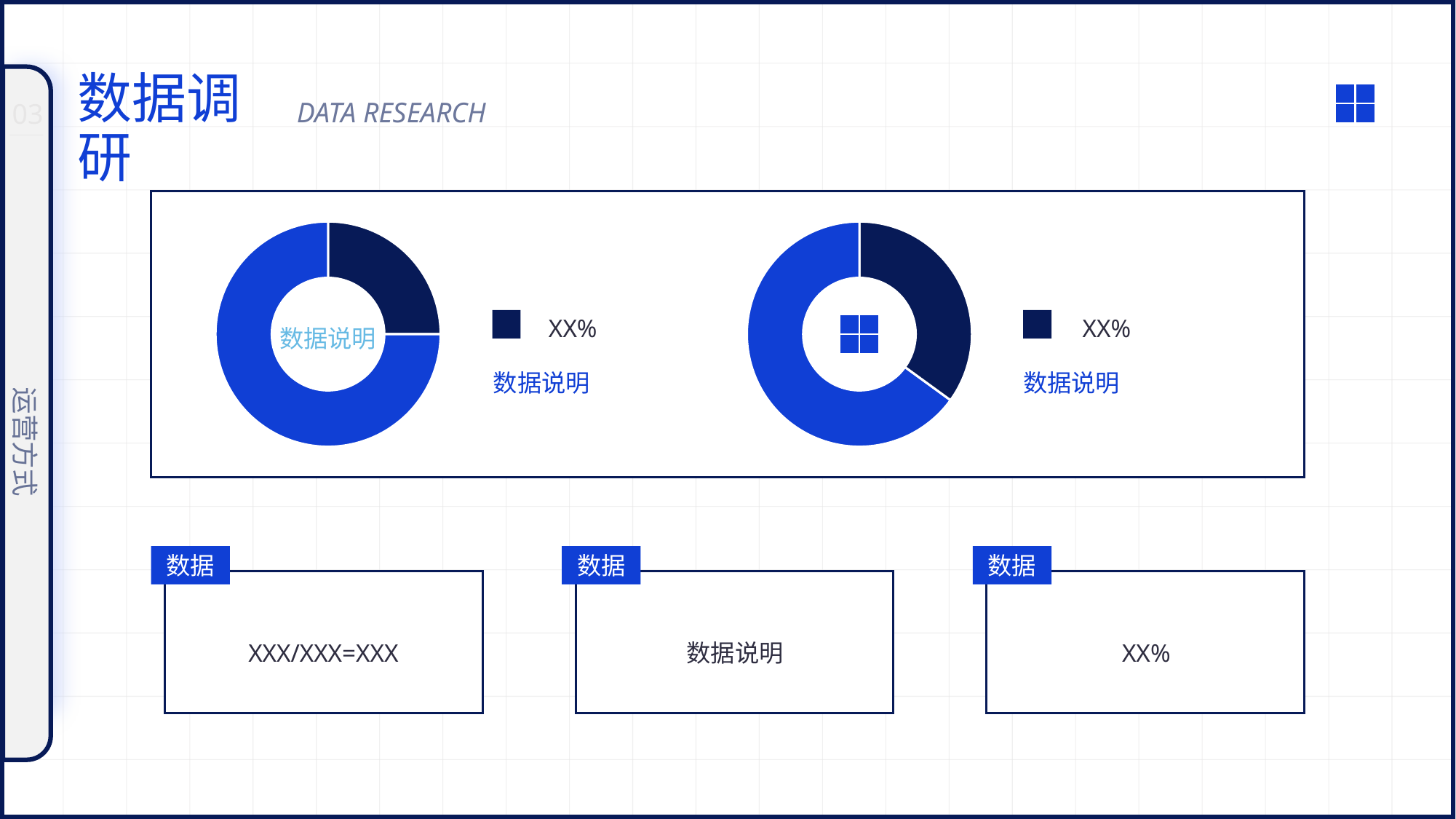
How many charts are shown on the slide? 2 In the right donut chart, how many slices are there? 2 What text is printed in the centre of the left donut chart? 数据说明 What kind of chart is the left chart on the slide? donut chart In the left donut chart, how many slices are there? 2 What kind of chart is the right chart on the slide? donut chart Which chart has the larger dark navy slice, the left donut chart or the right donut chart? the right donut chart In the right donut chart, which slice is larger, the bright blue one or the dark navy one? the bright blue one In the left donut chart, does the dark navy slice take up more or less than half of the ring? less What value label is shown in the legend next to the right donut chart? XX%